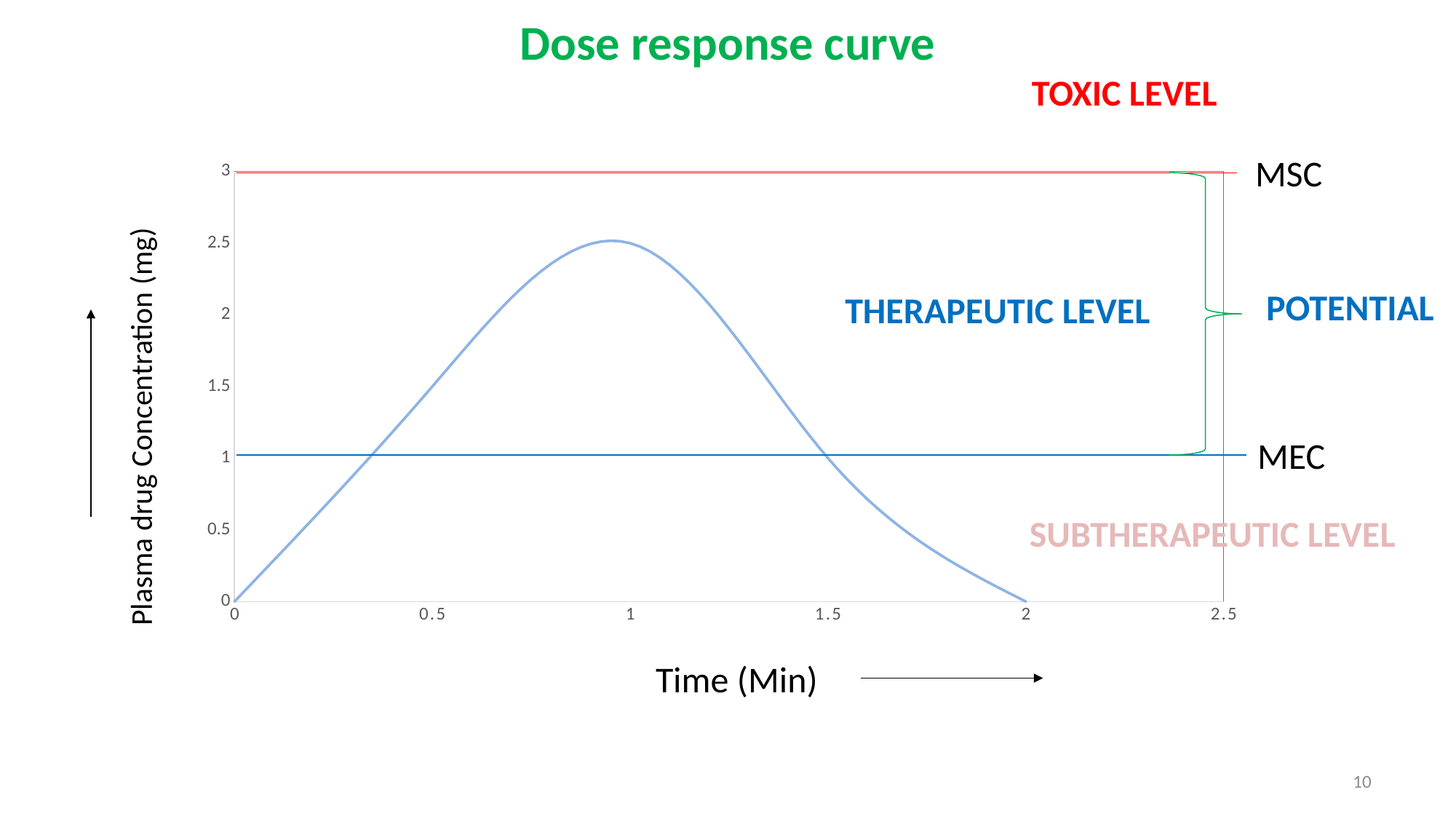
What is the difference between the MSC level and the MEC level? 2 At what concentration is the MSC line drawn? 3 What kind of chart is shown on the slide? line chart Is the plasma drug concentration at time 0.25 greater or less than 1? less What is the plasma drug concentration at time 0? 0 What is the label of the x axis? Time (Min) At what time does the curve reach its highest concentration? 1 What is the plasma drug concentration at time 2? 0 What is the title of the chart? Dose response curve What is the peak plasma drug concentration reached by the curve? 2.5 Is the plasma drug concentration at time 0.5 greater or less than 1? greater At what concentration is the horizontal MEC line drawn? 1